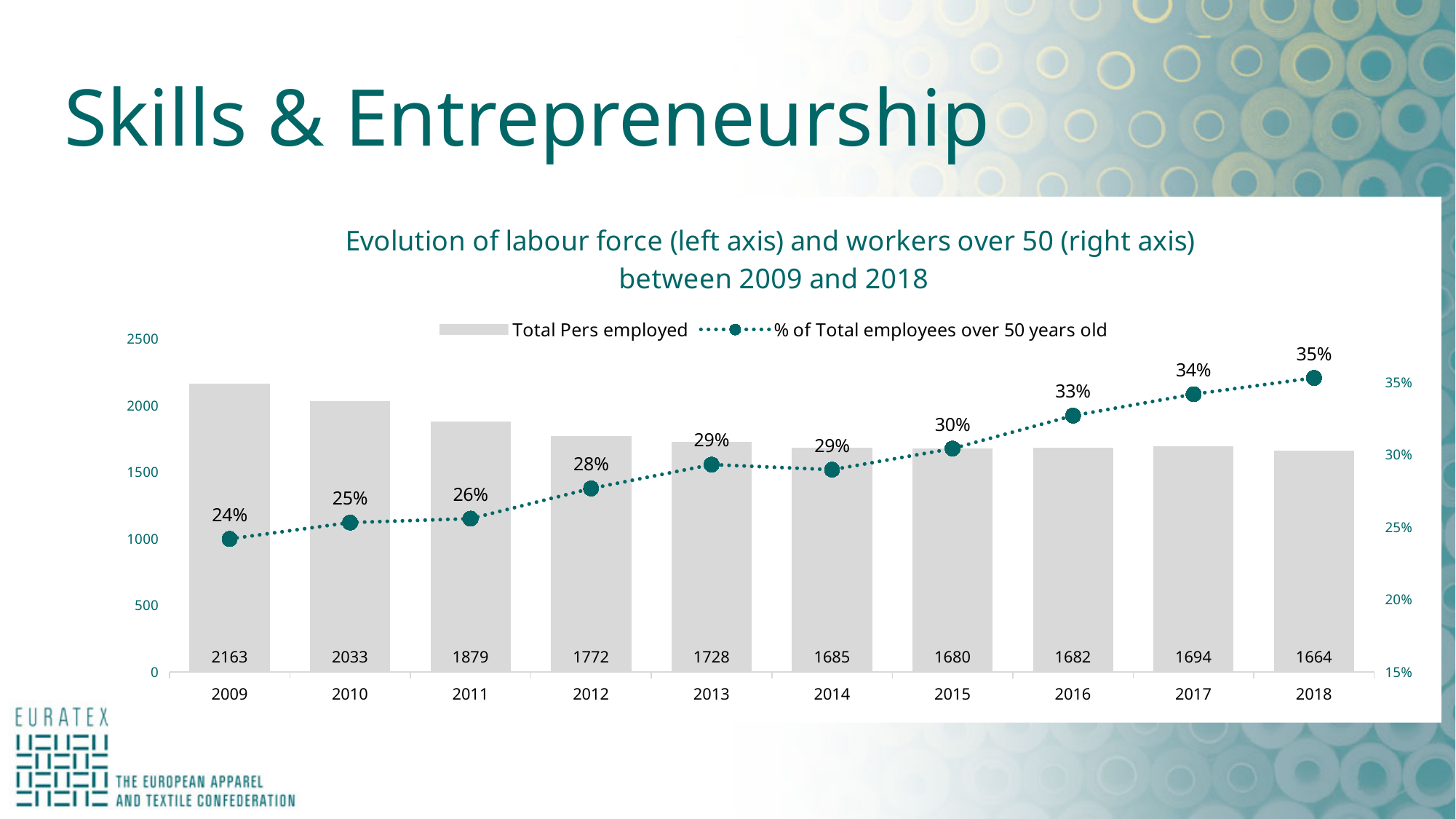
What is the title of the chart? Evolution of labour force (left axis) and workers over 50 (right axis) between 2009 and 2018 What is the Total Pers employed value for 2009? 2163 How many series does the legend list? 2 What is the difference in Total Pers employed between 2009 and 2018? 499 What is the overall trend of the % of Total employees over 50 years old from 2009 to 2018? Rising Which is larger, the Total Pers employed in 2016 or in 2017? 2017 How many years are shown on the x axis? 10 What is the Total Pers employed value for 2014? 1685 Which year has the lowest Total Pers employed? 2018 What is the % of Total employees over 50 years old in 2018? 35% Which year has the highest Total Pers employed? 2009 Which year has the lowest % of Total employees over 50 years old? 2009